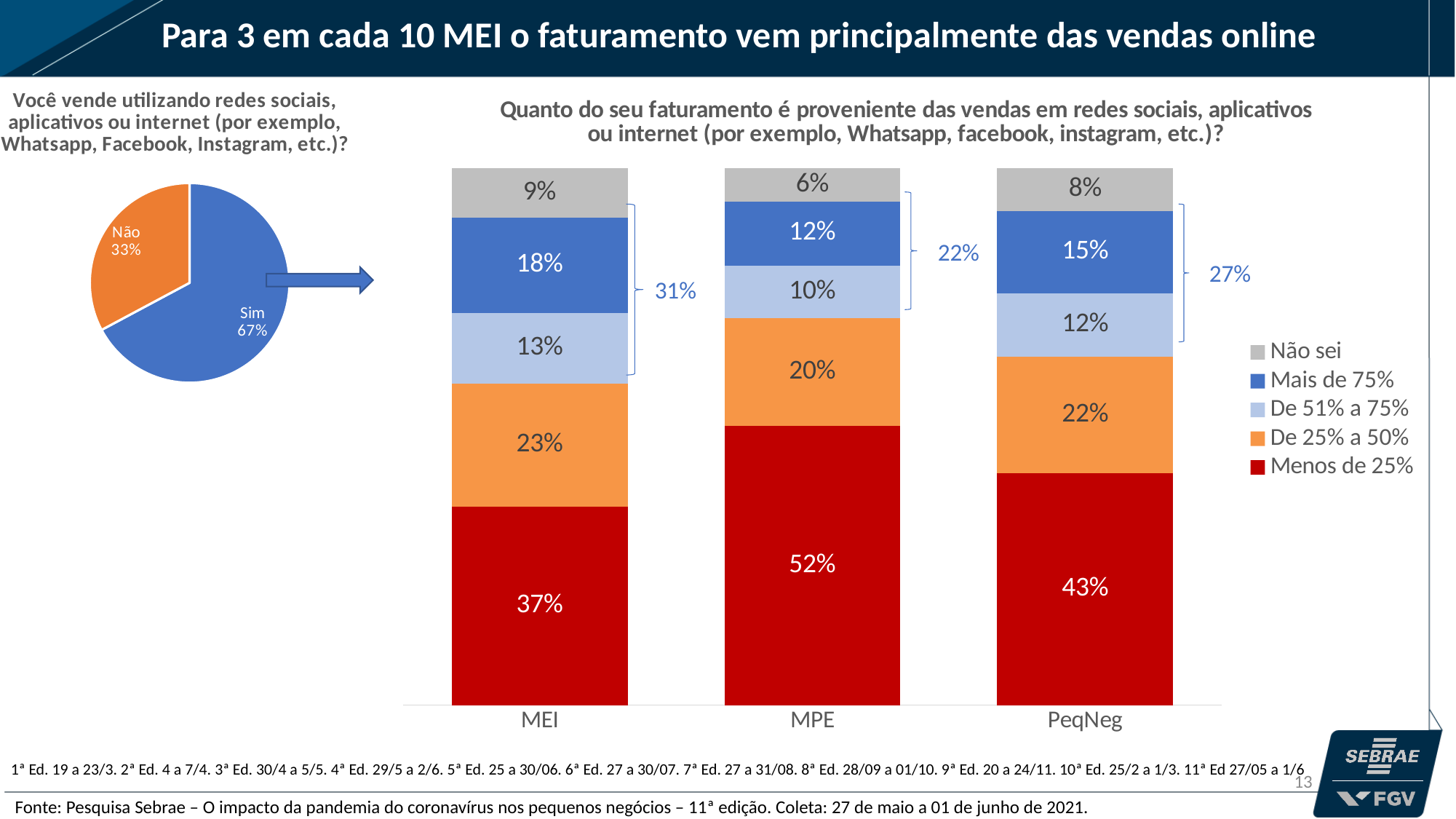
What kind of chart is the chart on the left of the slide? Pie chart In the stacked bar chart on the right, which category has the lowest value for "Não sei"? MPE In the stacked bar chart on the right, what is the value of "Menos de 25%" for MPE? 52% In the pie chart on the left, what share of respondents answered "Não"? 33% In the stacked bar chart on the right, what is the value of "Mais de 75%" for MEI? 18% In the stacked bar chart on the right, how many series does the legend list? 5 What kind of chart is the chart on the right of the slide? Stacked bar chart In the stacked bar chart on the right, what is the value of "De 25% a 50%" for PeqNeg? 22% In the pie chart on the left, what share of respondents answered "Sim"? 67% In the stacked bar chart on the right, how many categories are shown on the x axis? 3 In the stacked bar chart on the right, what is the difference between the "Menos de 25%" values for MPE and MEI? 15% In the stacked bar chart on the right, which category has the highest value for "Menos de 25%"? MPE